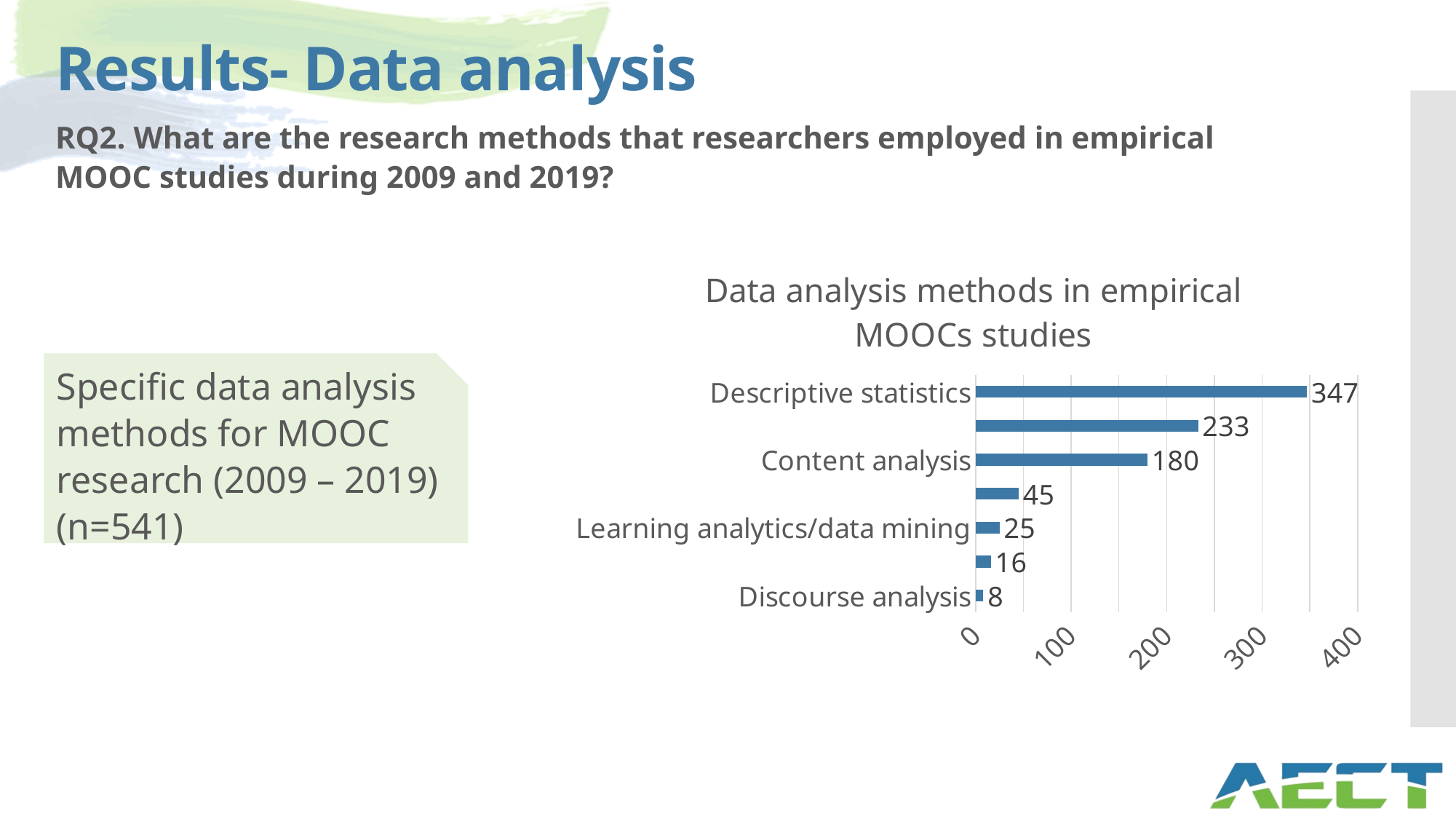
What kind of chart is shown on the slide? Bar chart Which data analysis method has the lowest value? Discourse analysis What is the title of the chart? Data analysis methods in empirical MOOCs studies Which is larger, the value for Content analysis or the value for Learning analytics/data mining? Content analysis What is the value for Content analysis? 180 What is the value for Discourse analysis? 8 What is the value for Learning analytics/data mining? 25 What is the difference between the values for Descriptive statistics and Content analysis? 167 What is the value for Descriptive statistics? 347 Which data analysis method has the highest value? Descriptive statistics How many bars are plotted in the chart? 7 Is the value for Descriptive statistics greater or less than 300? greater